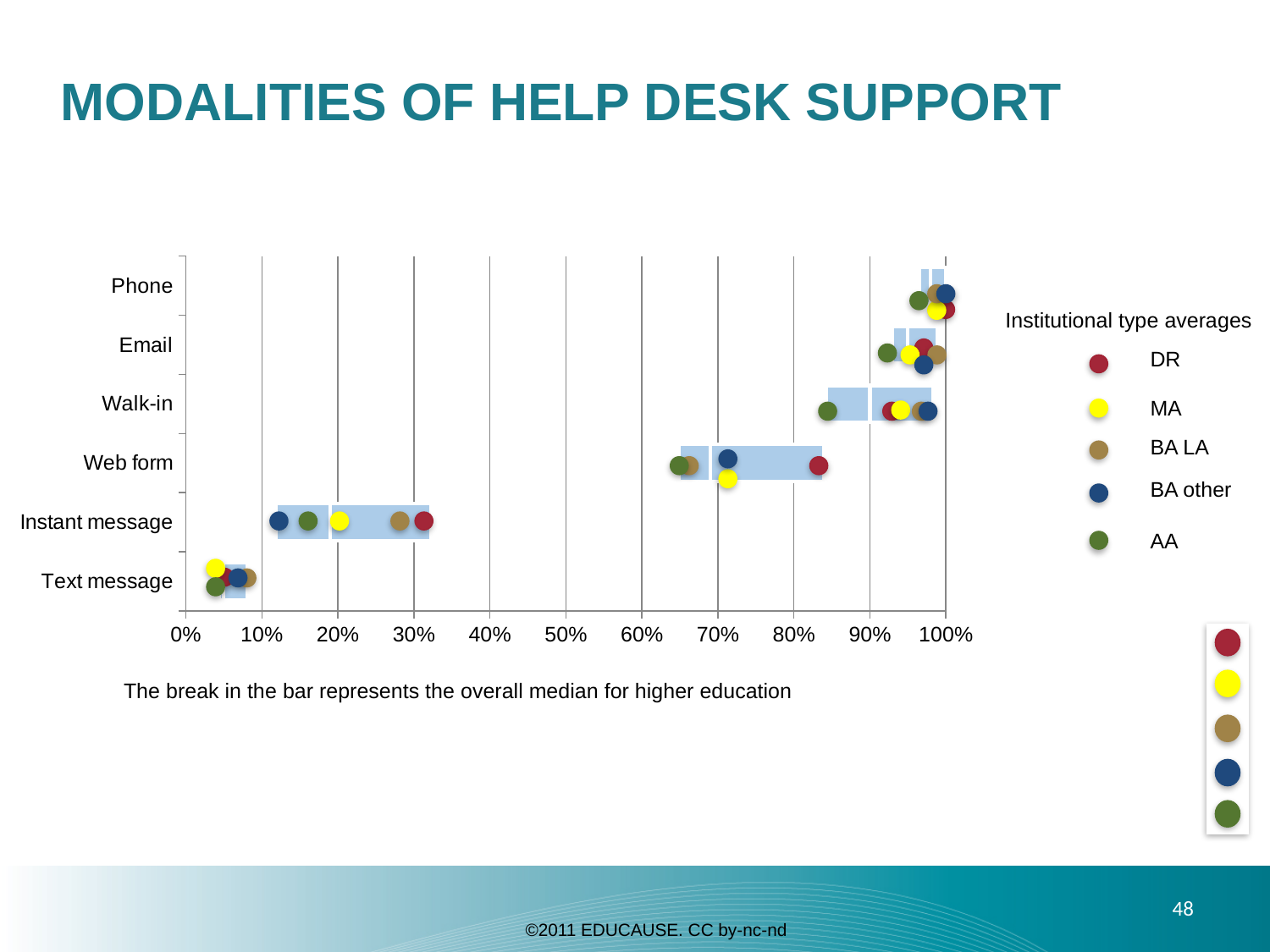
What is the title of the slide? MODALITIES OF HELP DESK SUPPORT How many help desk support modalities are listed on the vertical axis? 6 Is the DR value for Web form greater or less than 80%? greater Is the MA value for Text message greater or less than 10%? less Which modality has the highest values across institutional types? Phone Is the AA value for Web form greater or less than 70%? less How many institutional types does the legend list? 5 For Instant message, which is larger, the BA other value or the DR value? DR For Web form, which is larger, the DR value or the AA value? DR Which modality has the lowest values across institutional types? Text message What kind of chart is shown on the slide? bar chart